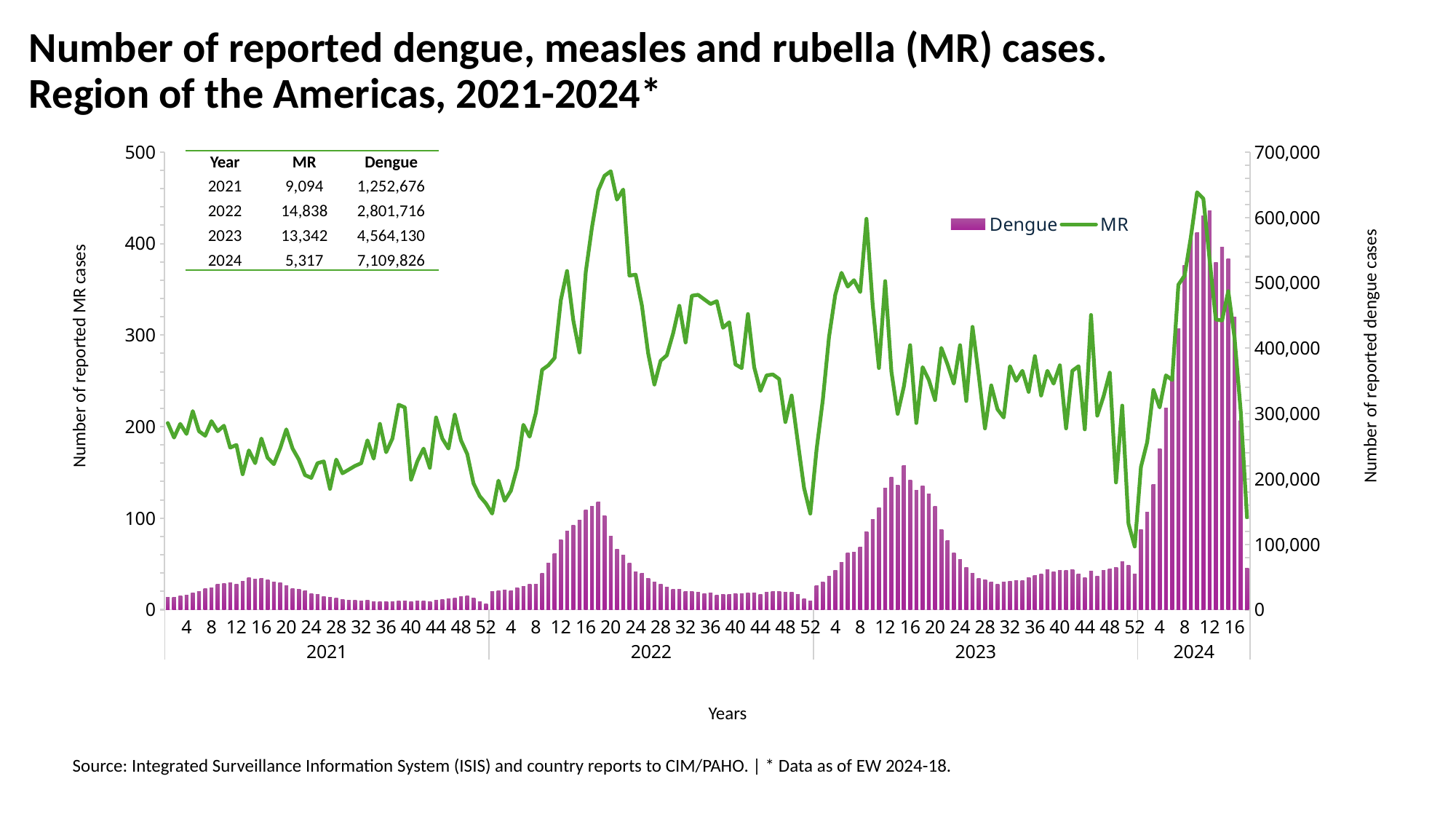
Is the peak weekly dengue value in 2024 greater or less than 500,000? greater Which year has more dengue cases in the inset table, 2023 or 2024? 2024 Which year in the inset table has the highest number of MR cases? 2022 According to the inset table, how many dengue cases were reported in 2023? 4,564,130 What is the difference between the MR cases in 2022 and in 2023 shown in the inset table? 1,496 According to the inset table, how many MR cases were reported in 2022? 14,838 Which series is drawn as a green line? MR What kind of chart is shown on the slide? A combined bar and line chart Do the annual dengue totals in the inset table rise or fall from 2021 to 2024? rise How many series does the chart legend list? 2 How many years are covered along the x axis of the chart? 4 Which year in the inset table has the lowest number of dengue cases? 2021